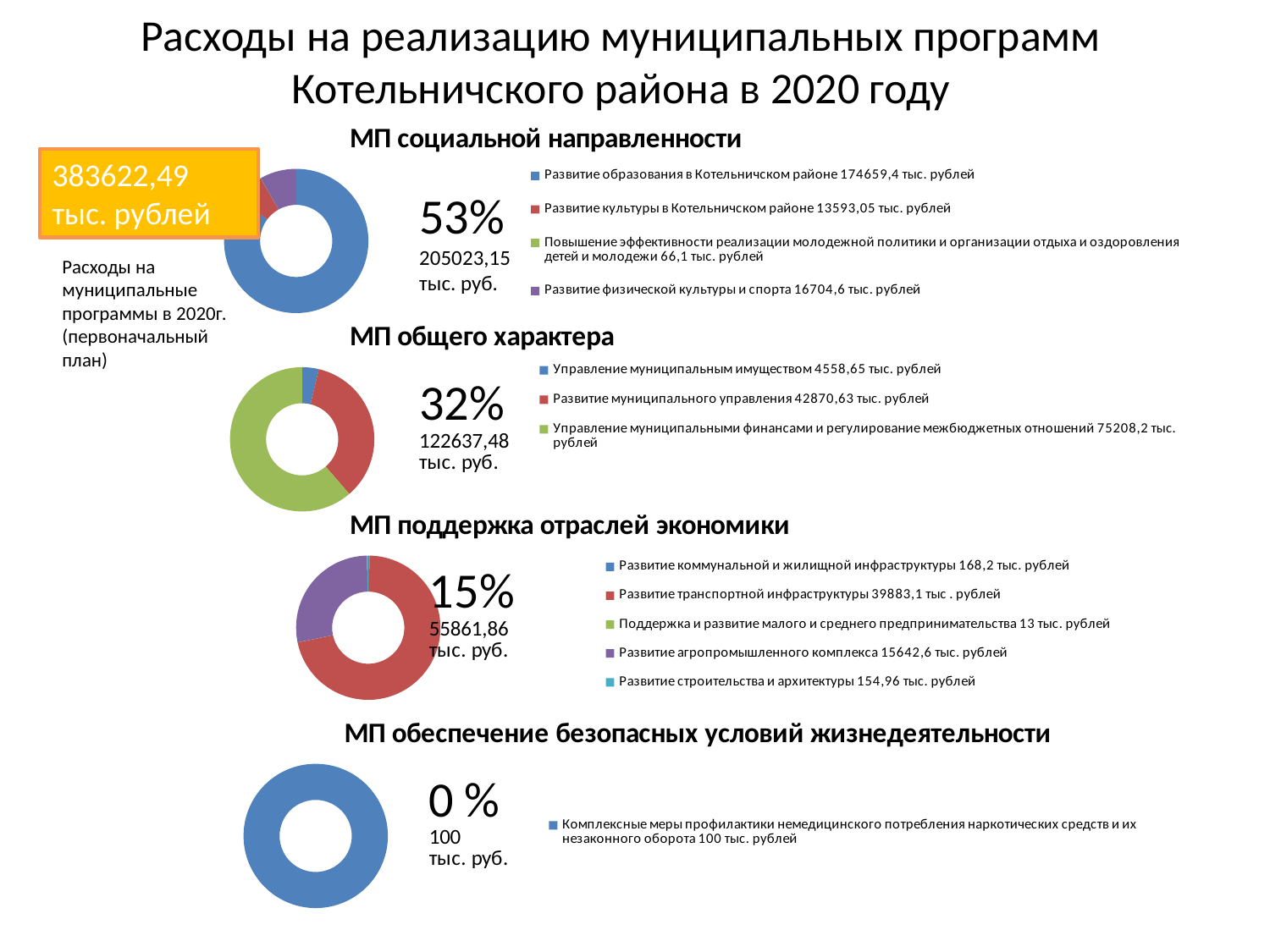
In the 'МП поддержка отраслей экономики' chart, which is larger: 'Развитие транспортной инфраструктуры' or 'Развитие агропромышленного комплекса'? Развитие транспортной инфраструктуры What percentage is shown next to the 'МП поддержка отраслей экономики' chart? 15% In the 'МП общего характера' chart, what is the value for 'Управление муниципальным имуществом'? 4558,65 тыс. рублей How many categories does the legend of the 'МП поддержка отраслей экономики' chart list? 5 In the 'МП общего характера' chart, which category has the largest value? Управление муниципальными финансами и регулирование межбюджетных отношений In the 'МП поддержка отраслей экономики' chart, what is the value for 'Поддержка и развитие малого и среднего предпринимательства'? 13 тыс. рублей In the 'МП социальной направленности' chart, what is the value for 'Развитие образования в Котельничском районе'? 174659,4 тыс. рублей In the 'МП общего характера' chart, what is the difference between 'Управление муниципальными финансами и регулирование межбюджетных отношений' and 'Развитие муниципального управления'? 32337,57 тыс. рублей What total value is shown next to the 'МП обеспечение безопасных условий жизнедеятельности' chart? 100 тыс. руб. What kind of chart is used for 'МП социальной направленности'? Doughnut chart In the 'МП социальной направленности' chart, which category has the smallest value? Повышение эффективности реализации молодежной политики и организации отдыха и оздоровления детей и молодежи How many categories does the legend of the 'МП социальной направленности' chart list? 4